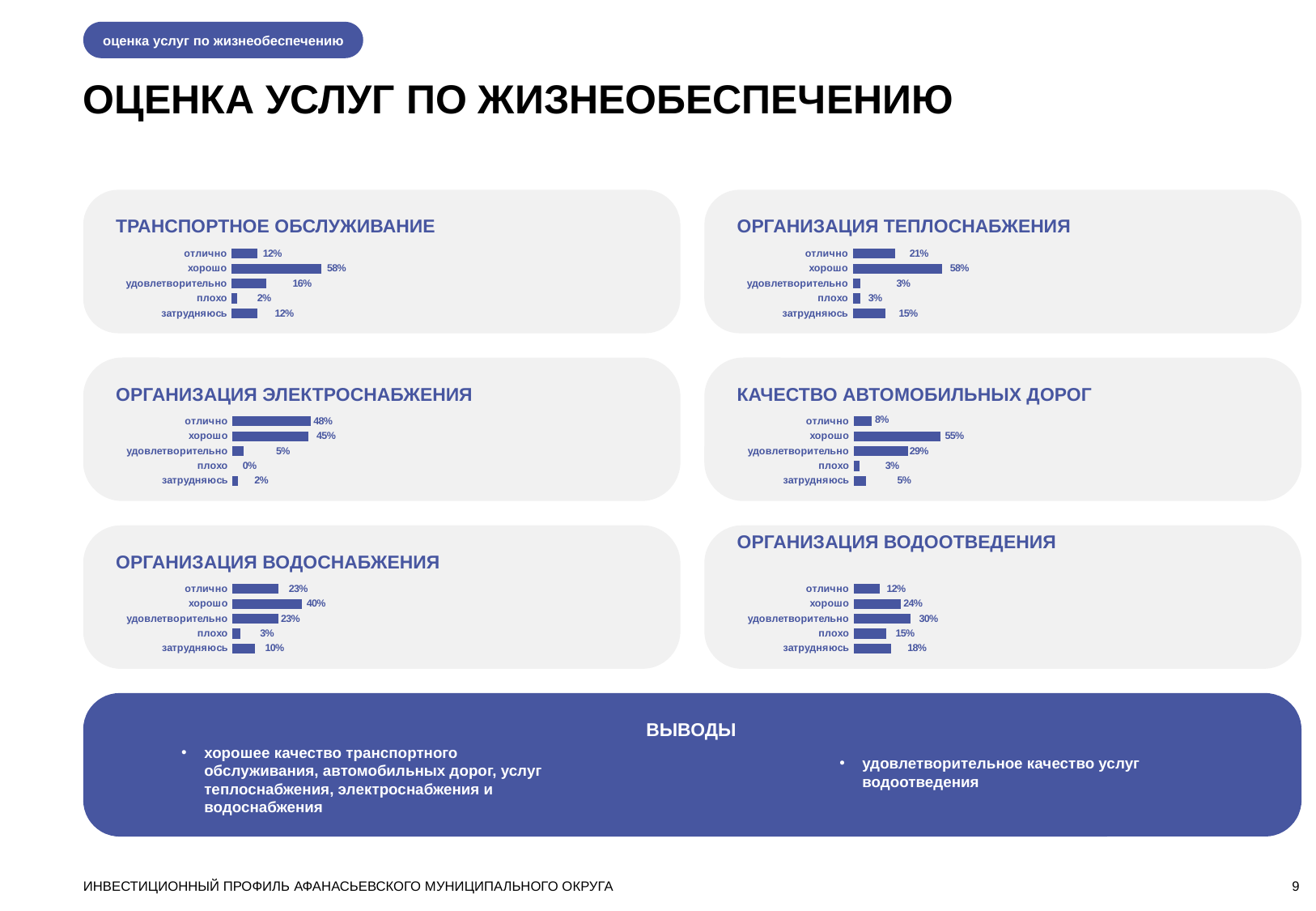
In the chart titled ОРГАНИЗАЦИЯ ВОДОСНАБЖЕНИЯ, which is larger: хорошо or отлично? хорошо In the chart titled ОРГАНИЗАЦИЯ ВОДООТВЕДЕНИЯ, what is the value for плохо? 15% In the chart titled ОРГАНИЗАЦИЯ ЭЛЕКТРОСНАБЖЕНИЯ, which category has the lowest value? плохо In the chart titled ОРГАНИЗАЦИЯ ВОДОСНАБЖЕНИЯ, what is the difference between хорошо and затрудняюсь? 30% How many charts are shown on the slide? 6 In the chart titled КАЧЕСТВО АВТОМОБИЛЬНЫХ ДОРОГ, what is the difference between хорошо and удовлетворительно? 26% In the chart titled ОРГАНИЗАЦИЯ ТЕПЛОСНАБЖЕНИЯ, what is the value for отлично? 21% In the chart titled ОРГАНИЗАЦИЯ ВОДООТВЕДЕНИЯ, which category has the highest value? удовлетворительно In the chart titled ОРГАНИЗАЦИЯ ЭЛЕКТРОСНАБЖЕНИЯ, which category has the highest value? отлично What kind of chart is the one titled ОРГАНИЗАЦИЯ ТЕПЛОСНАБЖЕНИЯ? bar chart In the chart titled ТРАНСПОРТНОЕ ОБСЛУЖИВАНИЕ, what is the value for хорошо? 58% How many categories does the chart titled ТРАНСПОРТНОЕ ОБСЛУЖИВАНИЕ show? 5